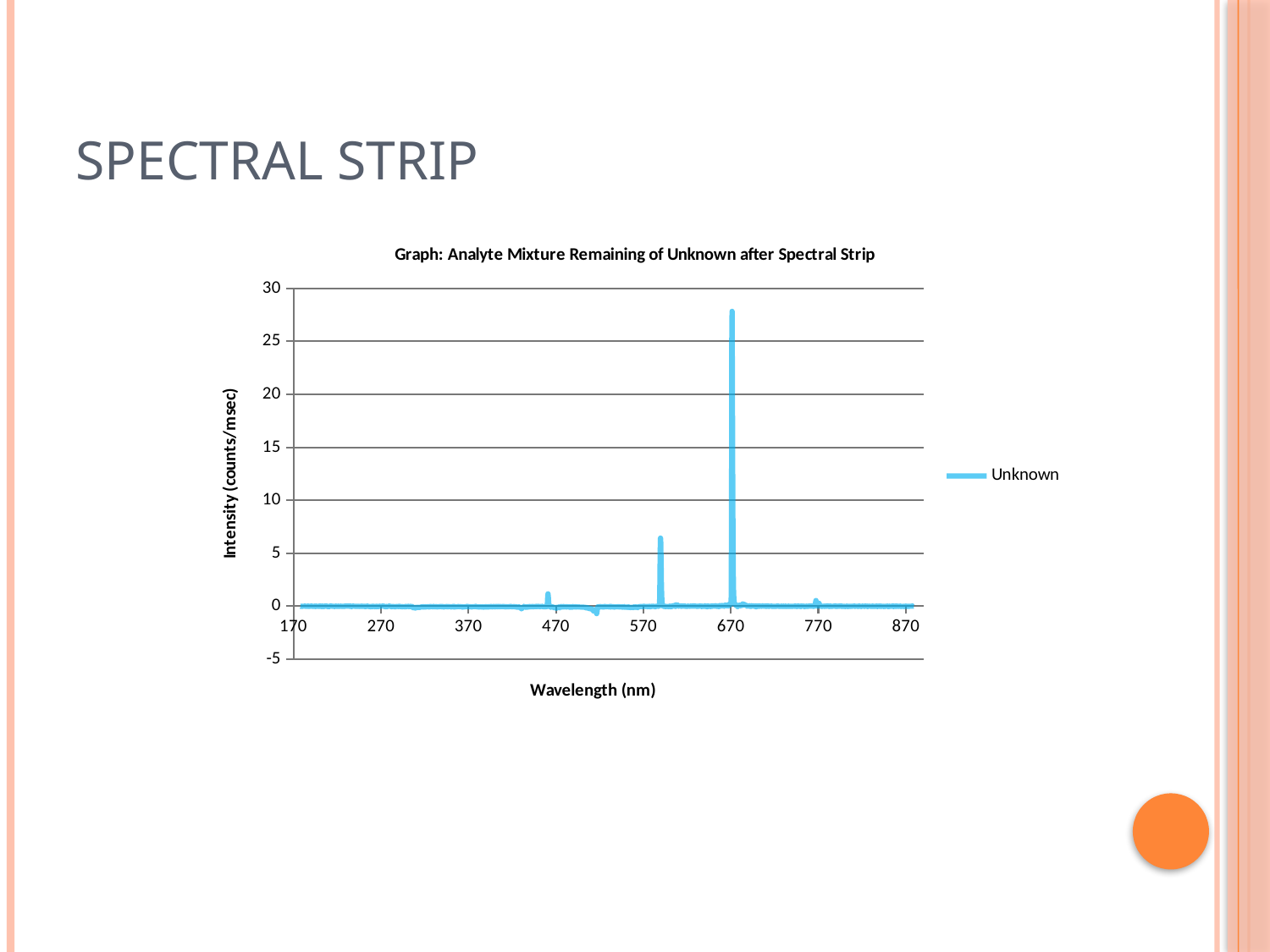
How many peaks in the chart rise above 5 counts/msec? 2 Is the intensity of the second-tallest peak (near 590 nm) greater or less than 5 counts/msec? greater Is the intensity of the tallest peak (near 670 nm) greater or less than 30 counts/msec? less Which peak is taller: the one near 590 nm or the one near 670 nm? the one near 670 nm Is the small peak near 470 nm greater or less than 5 counts/msec? less How many series does the chart legend list? 1 What is the title of the chart? Graph: Analyte Mixture Remaining of Unknown after Spectral Strip What is the name of the series shown in the chart legend? Unknown What kind of chart is shown on the slide? line chart Near which wavelength tick on the x axis does the tallest peak of the Unknown series occur? 670